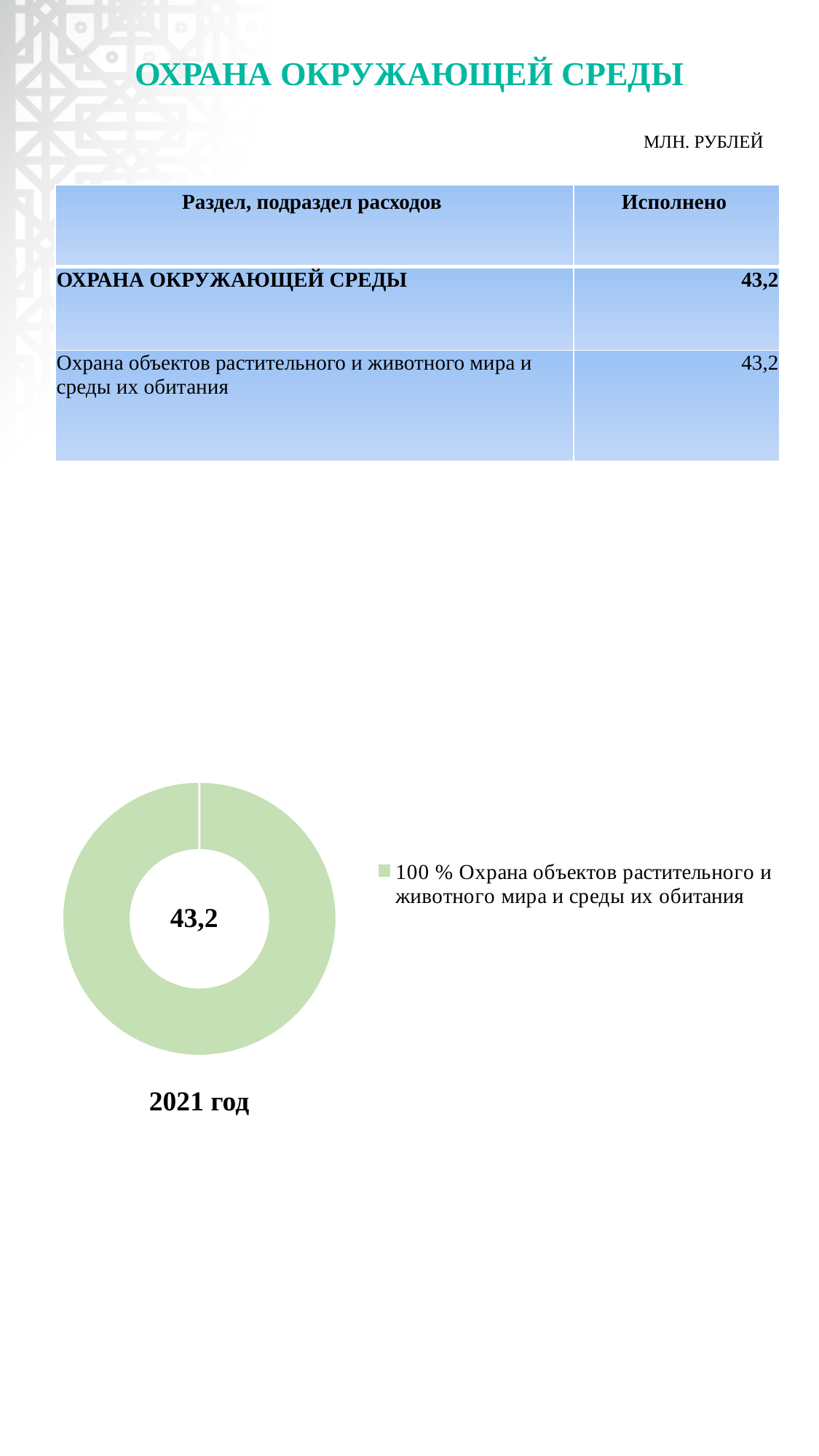
How many entries does the legend of the doughnut chart list? 1 What share of the doughnut chart does "Охрана объектов растительного и животного мира и среды их обитания" take? 100 % How many slices does the doughnut chart have? 1 What colour is the slice in the doughnut chart? Light green What kind of chart is shown on the slide? Doughnut chart What value is printed in the centre of the doughnut chart? 43,2 Is the value shown in the centre of the doughnut chart greater or less than 40? greater What year is shown as the label under the doughnut chart? 2021 год